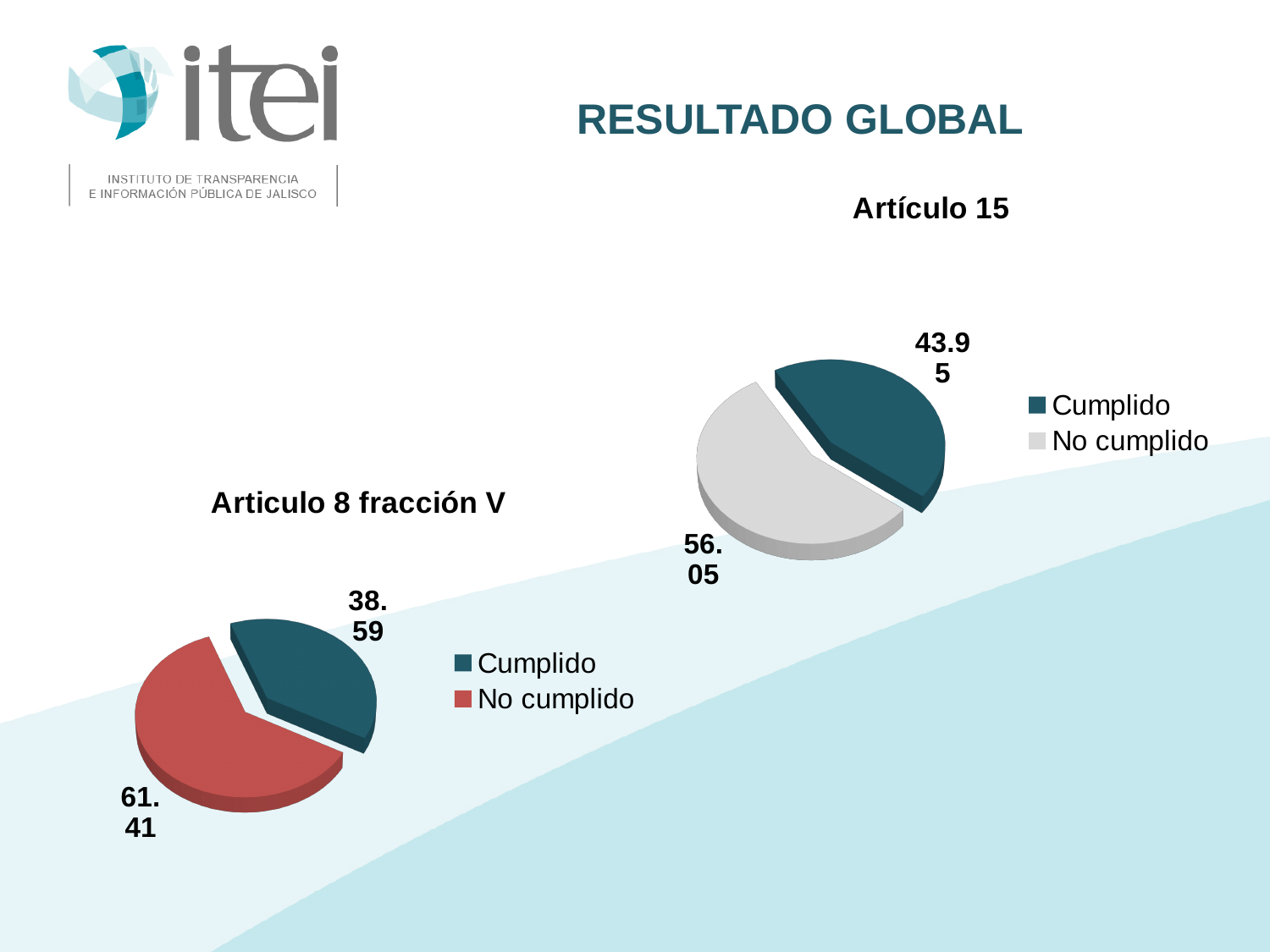
In the 'Articulo 8 fracción V' chart, what colour is the No cumplido slice? Red How many categories does the 'Artículo 15' chart show? 2 Is the Cumplido value larger in the 'Artículo 15' chart or in the 'Articulo 8 fracción V' chart? Artículo 15 In the 'Articulo 8 fracción V' chart, what is the value for No cumplido? 61.41 In the 'Artículo 15' chart, what is the value for No cumplido? 56.05 In the 'Articulo 8 fracción V' chart, what is the value for Cumplido? 38.59 In the 'Artículo 15' chart, what is the value for Cumplido? 43.95 What type of chart is used for 'Articulo 8 fracción V'? Pie chart In the 'Artículo 15' chart, what is the difference between No cumplido and Cumplido? 12.1 In the 'Articulo 8 fracción V' chart, what is the difference between No cumplido and Cumplido? 22.82 In the 'Artículo 15' chart, which category has the larger slice? No cumplido In the 'Articulo 8 fracción V' chart, which category has the smaller slice? Cumplido